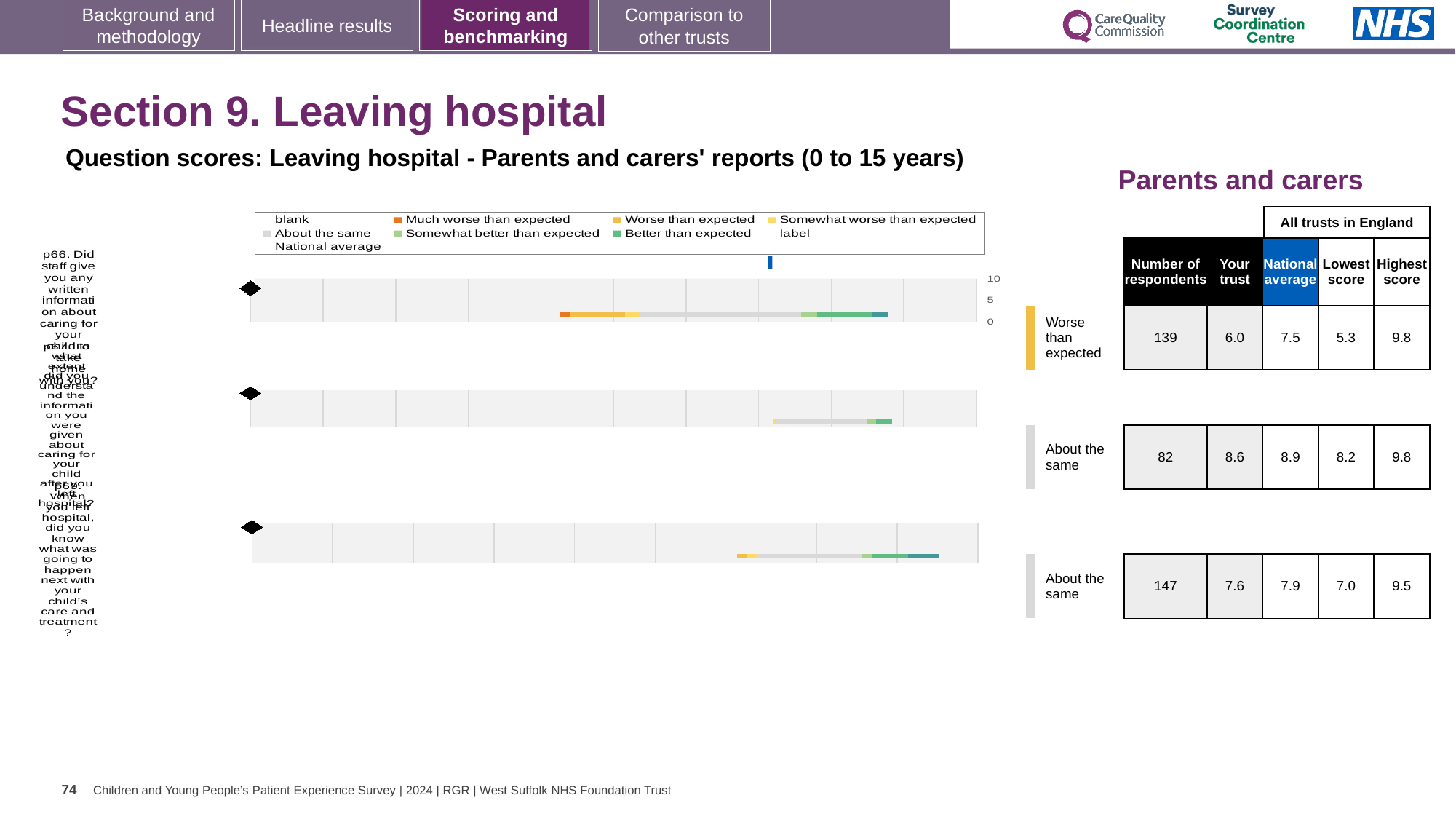
What benchmark category label is shown beside the bottom chart? About the same Which legend entry is shown in orange in the chart legend? Much worse than expected For the middle chart's question, what is the national average in the table? 8.9 For the top chart's question, what is the 'Your trust' score in the table? 6.0 Is the 'Your trust' score for the bottom chart's question larger or smaller than its national average? Smaller How many question-score charts are shown on the slide? 3 For the bottom chart's question, how many respondents are listed in the table? 147 What is the difference between the national average and the 'Your trust' score for the top chart's question? 1.5 Which legend entry is shown in grey in the chart legend? About the same What kind of chart is used for the three question-score charts on the slide? Bar chart Which of the three questions has the highest 'Your trust' score in the table: the top, middle or bottom chart's question? Middle What benchmark category label is shown beside the top chart? Worse than expected